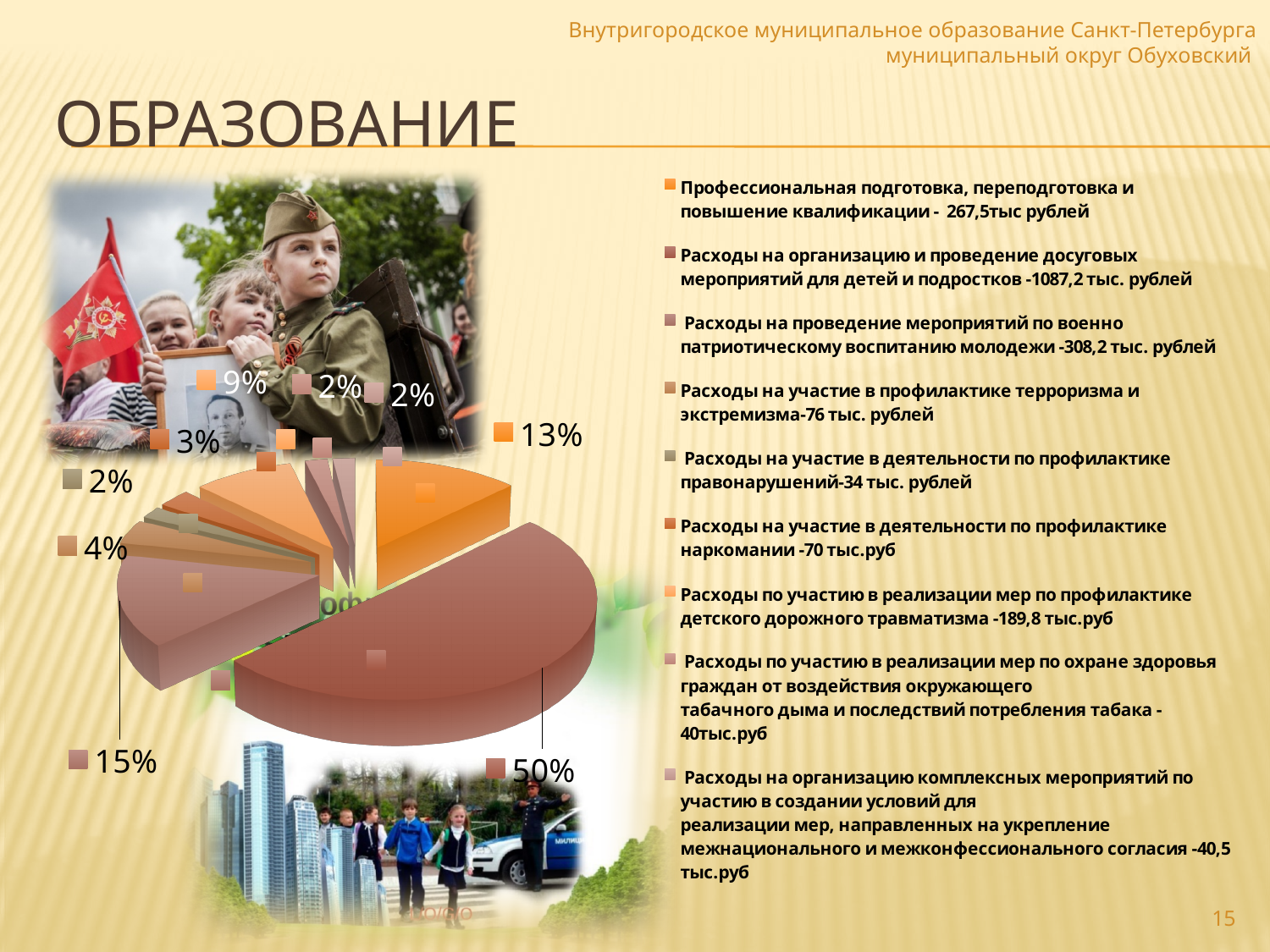
What is the difference in percentage points between the largest slice (50%) and the second largest slice (15%)? 35 What is the share of the largest slice in the pie chart? 50% What is the share of the smallest slices in the pie chart? 2% According to the legend, how much was spent on organising leisure events for children and teenagers (Расходы на организацию и проведение досуговых мероприятий для детей и подростков)? 1087,2 тыс. рублей What is the combined share of the slices labelled 50% and 13%? 63% According to the legend, how much was spent on participation in the prevention of terrorism and extremism (Расходы на участие в профилактике терроризма и экстремизма)? 76 тыс. рублей What kind of chart is shown on the slide? pie chart How many entries does the legend on the right of the pie chart list? 9 How many slices of the pie chart are labelled 2%? 3 How many slices does the pie chart have? 9 Which is larger in the pie chart: the slice labelled 13% or the slice labelled 15%? 15% What is the share of the second largest slice in the pie chart? 15%